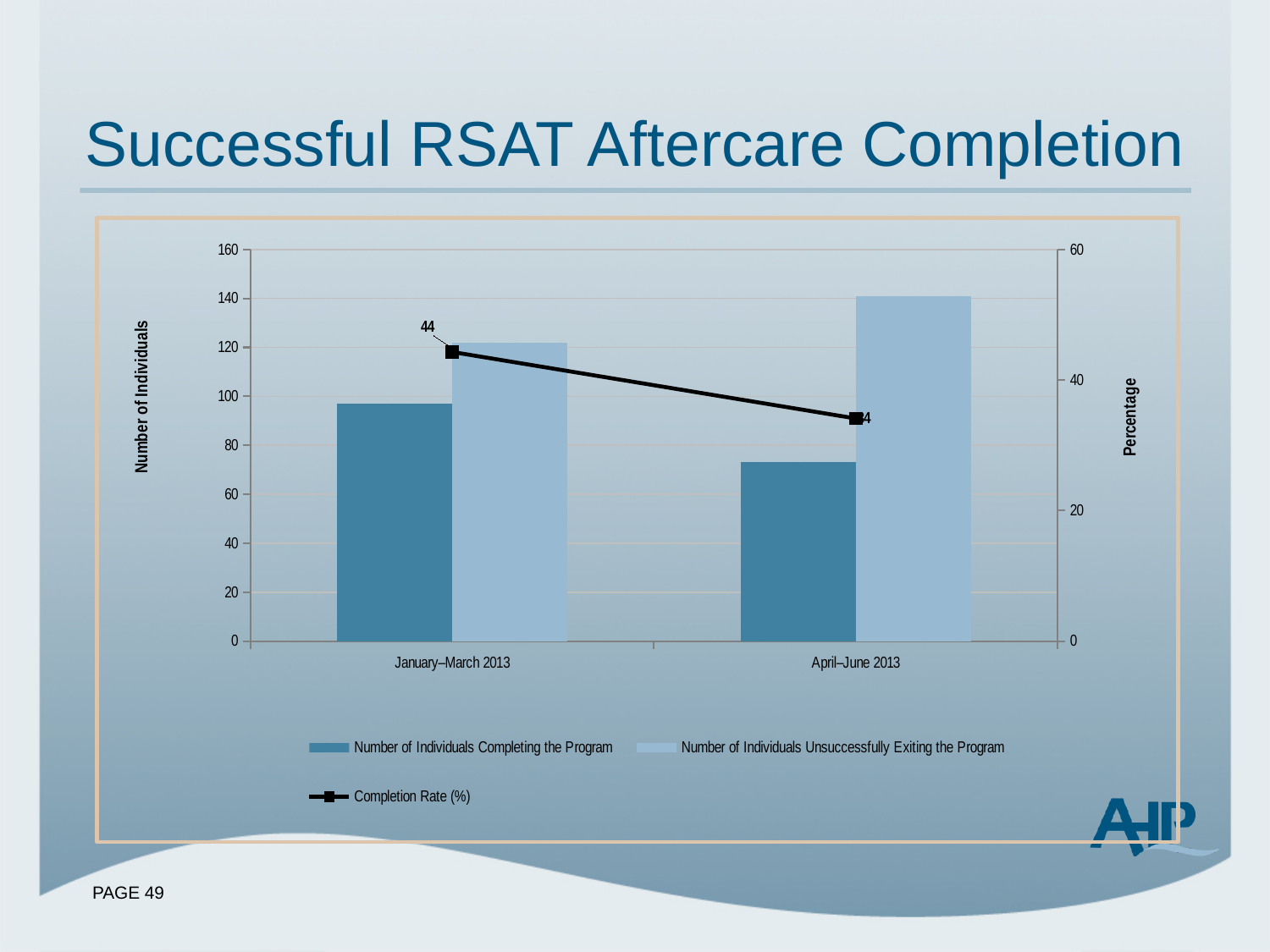
What is the Completion Rate (%) for January–March 2013? 44 How many time periods are shown on the x axis? 2 Is the Number of Individuals Unsuccessfully Exiting the Program for April–June 2013 greater or less than 120? greater Does the Completion Rate (%) rise or fall from January–March 2013 to April–June 2013? fall Which period has the higher Number of Individuals Completing the Program? January–March 2013 Is the Number of Individuals Completing the Program for January–March 2013 greater or less than 80? greater In January–March 2013, which is larger: the number completing the program or the number unsuccessfully exiting the program? Number of Individuals Unsuccessfully Exiting the Program What is the title of the right-hand vertical axis? Percentage Is the Number of Individuals Completing the Program for April–June 2013 greater or less than 80? less Which period has the higher Number of Individuals Unsuccessfully Exiting the Program? April–June 2013 How many series does the legend list? 3